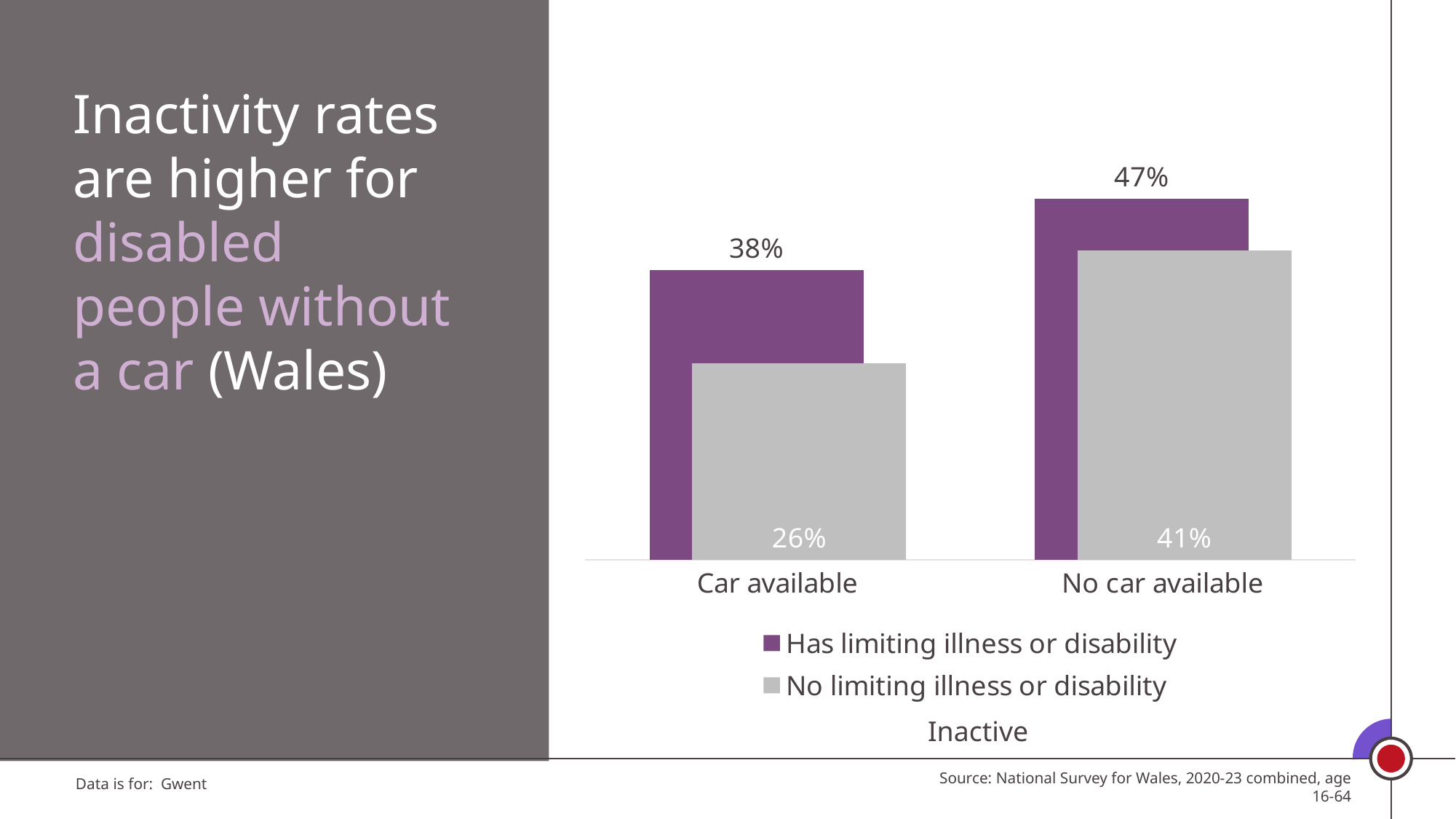
What is the inactivity rate for people with a limiting illness or disability who have no car available? 47% How many categories are shown on the x axis of the chart? 2 Is the inactivity rate higher for people with a limiting illness or disability with a car available, or for people with no limiting illness or disability with no car available? No limiting illness or disability with no car available What is the inactivity rate for people with a limiting illness or disability who have a car available? 38% Which group has the highest inactivity rate on the chart? Has limiting illness or disability, No car available How many series does the chart legend list? 2 What is the inactivity rate for people with no limiting illness or disability who have a car available? 26% Which group has the lowest inactivity rate on the chart? No limiting illness or disability, Car available What is the difference in inactivity rate between people with and without a limiting illness or disability in the 'Car available' category? 12% What is the inactivity rate for people with no limiting illness or disability who have no car available? 41% What type of chart is shown on the slide? Bar chart What is the difference in inactivity rate between people with and without a limiting illness or disability in the 'No car available' category? 6%